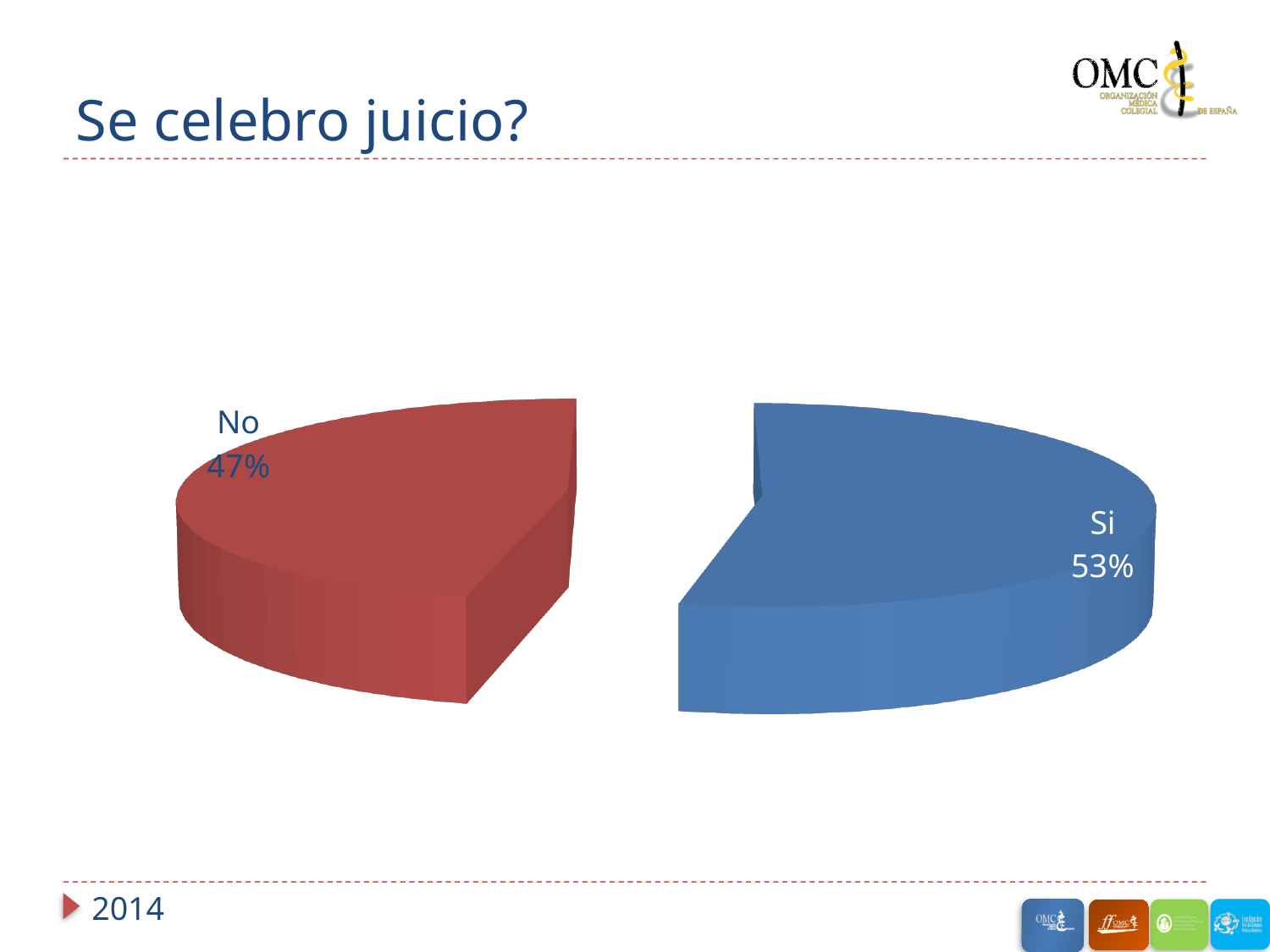
Which slice is the smallest in the pie chart? No Is the value for "No" greater or less than 50%? less What share of the pie does the "Si" slice represent? 53% Which slice is the largest in the pie chart? Si Which is larger, the "Si" slice or the "No" slice? Si What is the title of the slide containing the chart? Se celebro juicio? What kind of chart is shown on the slide? Pie chart What share of the pie does the "No" slice represent? 47% What is the difference in percentage points between the "Si" and "No" slices? 6 What colour is the "Si" slice? Blue How many slices does the pie chart have? 2